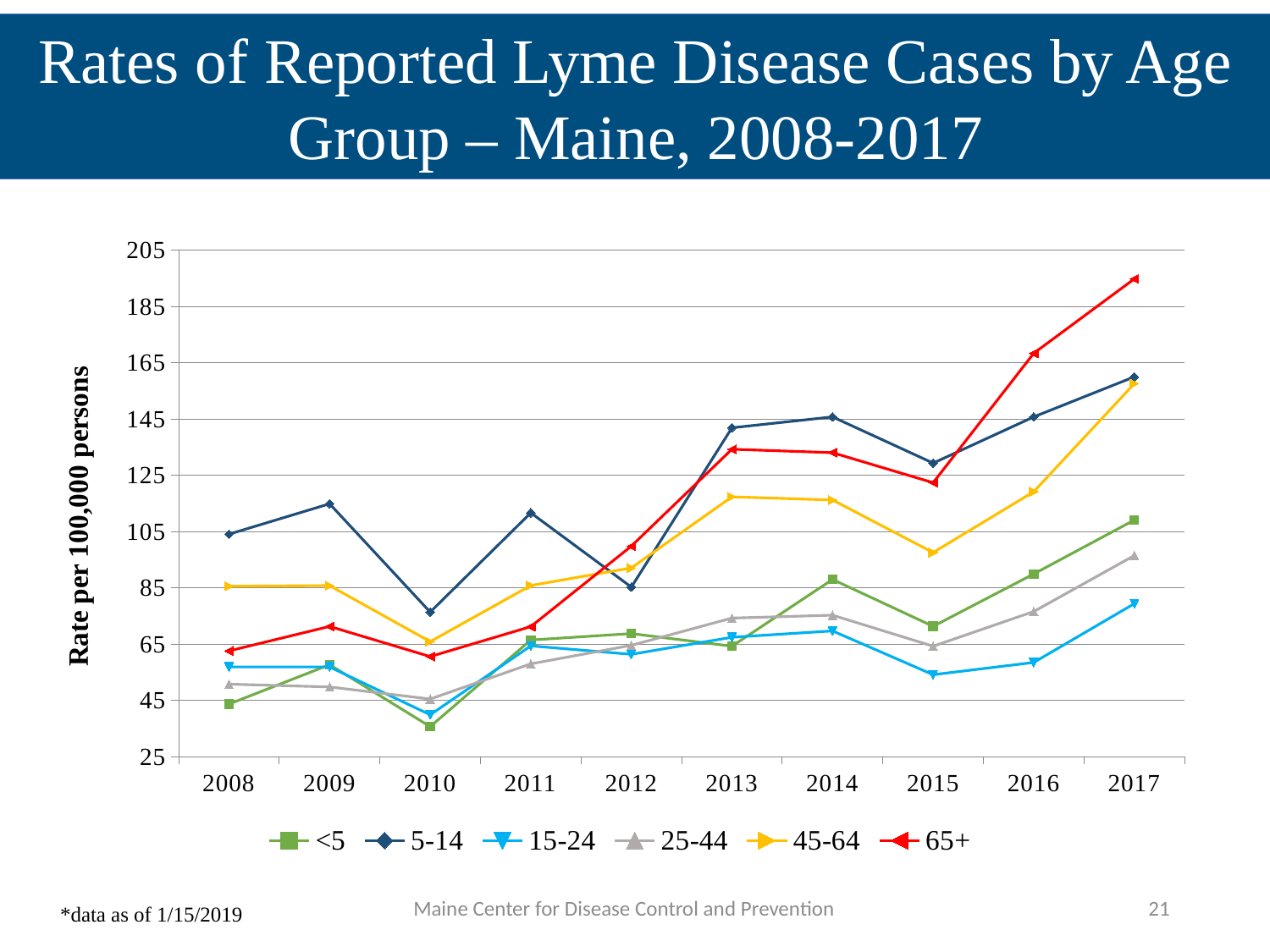
Does the rate for the 65+ age group rise or fall from 2015 to 2017? rise How many years are shown on the x axis? 10 How many age groups does the legend list? 6 What kind of chart is shown on the slide? line chart Is the rate for the <5 age group in 2010 greater or less than 45? less Which age group has the lowest rate in 2017? 15-24 Which age group has the highest rate in 2008? 5-14 Which age group has the highest rate in 2017? 65+ In 2012, which age group has the higher rate, 5-14 or 65+? 65+ Is the rate for the 65+ age group in 2017 greater or less than 185? greater Is the rate for the 15-24 age group in 2015 greater or less than 65? less Which age group has the lowest rate in 2010? <5